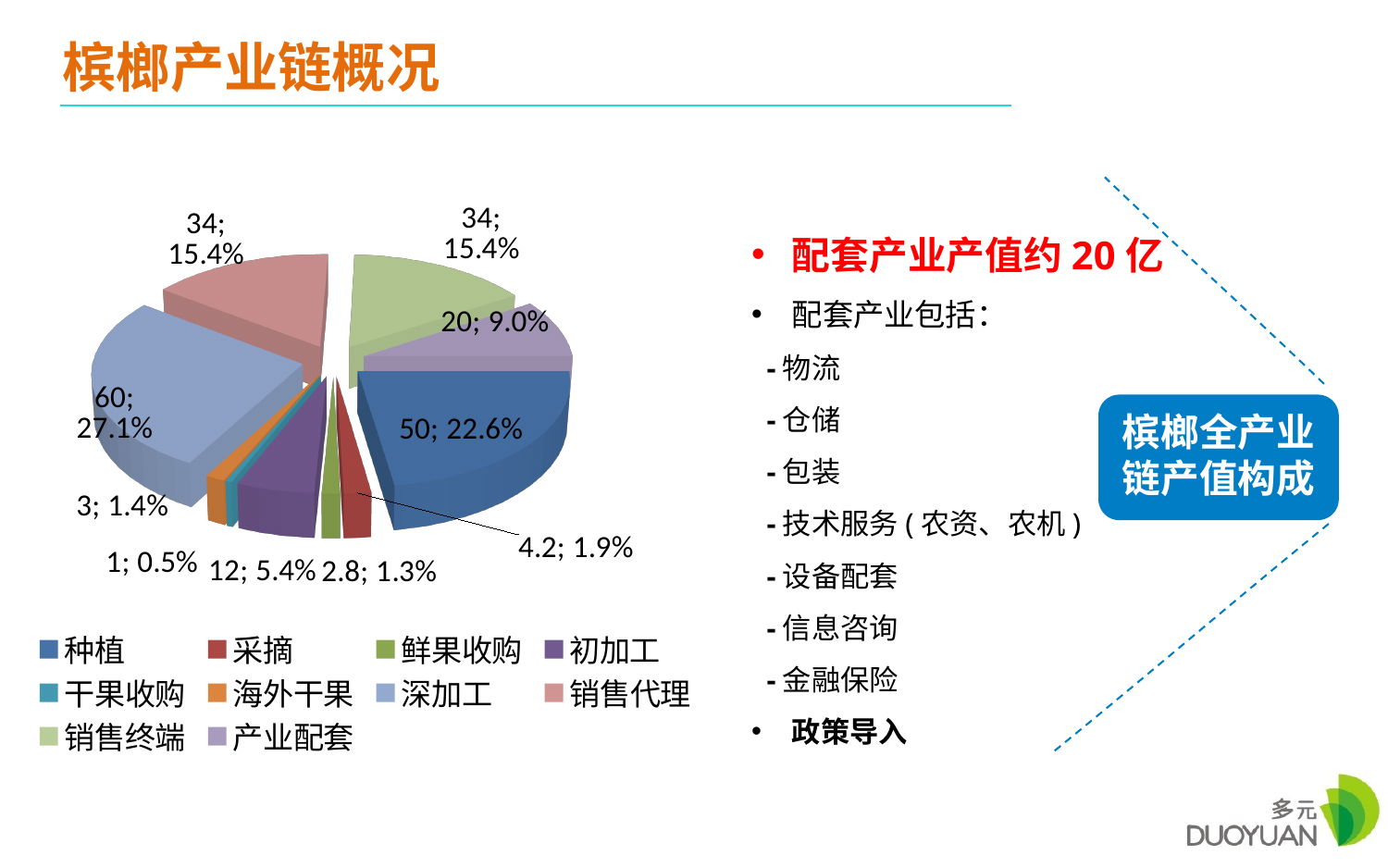
Which category has the smallest slice in the pie chart? 干果收购 What is the difference between the values of 深加工 and 种植? 10 What value is labelled on the 深加工 slice? 60; 27.1% How many categories does the pie chart's legend list? 10 What value is labelled on the 初加工 slice? 12; 5.4% What share of the pie does 产业配套 account for? 9.0% What is the title given for the pie chart in the blue box on the slide? 槟榔全产业链产值构成 What value is labelled on the 种植 slice? 50; 22.6% What share of the pie does 深加工 account for? 27.1% Which category has the largest slice in the pie chart? 深加工 Which is larger, the 种植 slice or the 深加工 slice? 深加工 What kind of chart is shown on the slide? pie chart